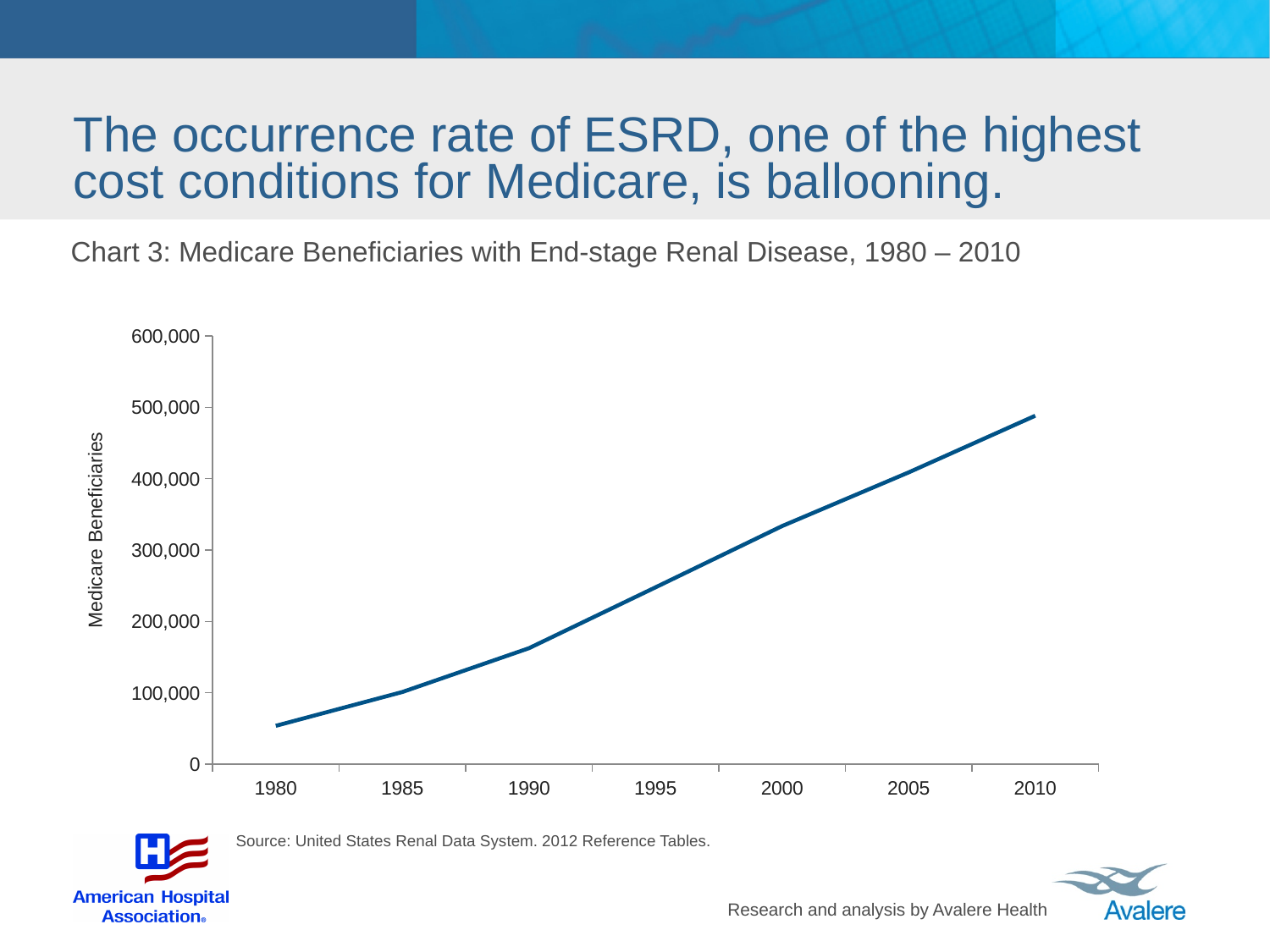
Is the value for 2000 greater or less than 300,000? greater Which year has the highest number of Medicare beneficiaries with ESRD in Chart 3? 2010 Is the value for 1980 greater or less than 100,000? less Do the values in Chart 3 rise or fall from 1980 to 2010? Rise Is the value for 2005 greater or less than 500,000? less Which year has the lowest number of Medicare beneficiaries with ESRD in Chart 3? 1980 What kind of chart is shown on the slide? Line chart How many year labels are shown on the x axis of Chart 3? 7 Which year has a larger value, 1990 or 2000? 2000 What is the label on the y axis of Chart 3? Medicare Beneficiaries